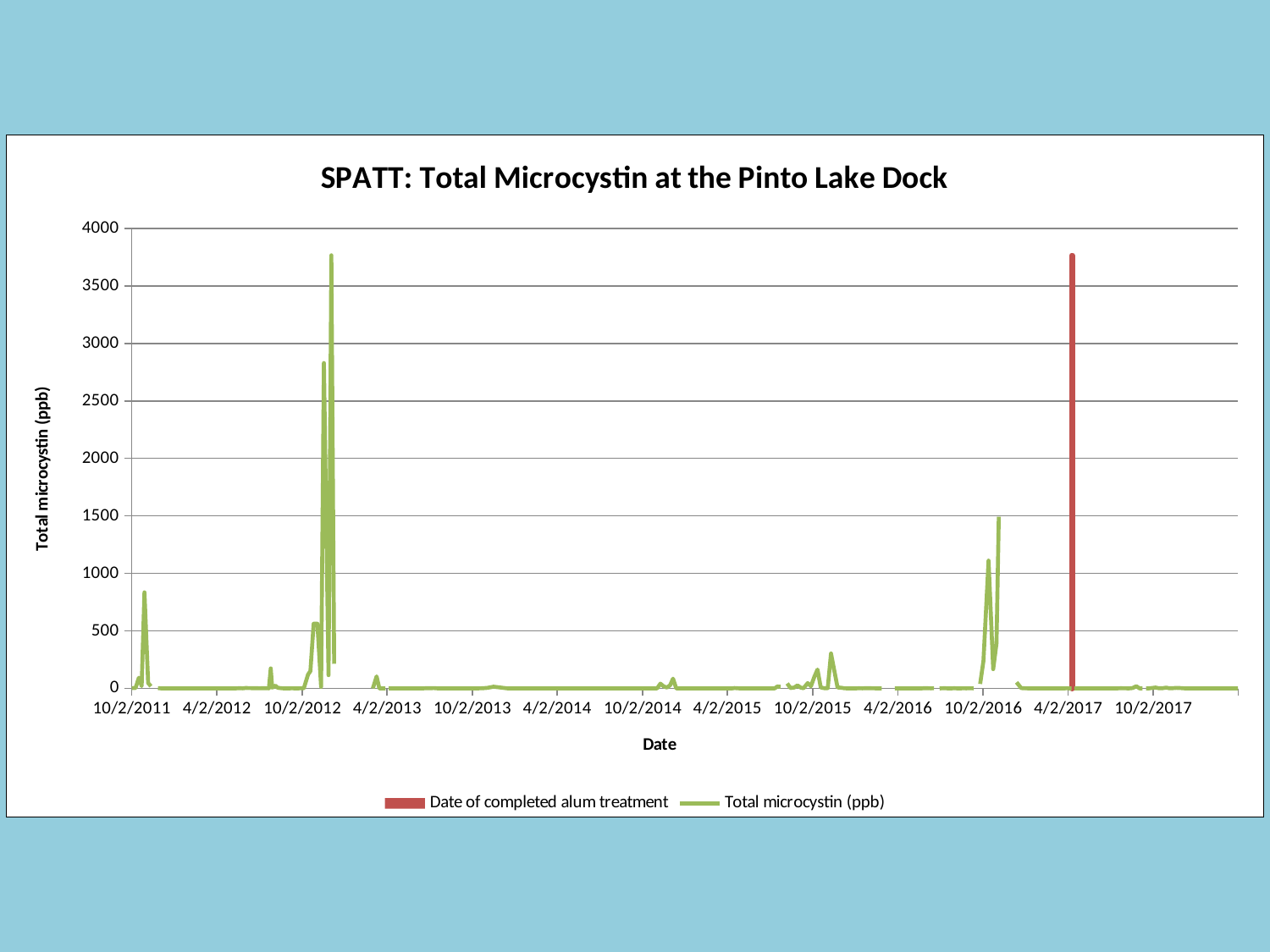
Is the total microcystin peak shortly after 10/2/2011 greater or less than 500? greater Is the highest total microcystin peak shortly after 10/2/2016 greater or less than 1000? greater What is the title of the chart? SPATT: Total Microcystin at the Pinto Lake Dock What kind of chart is shown on the slide? combination bar and line chart In which period does the highest total microcystin value on the chart occur? late 2012 Are the total microcystin values after the alum treatment date (4/2/2017 onward) greater or less than 500? less How many series does the legend list? 2 What are the two entries in the chart legend? Date of completed alum treatment; Total microcystin (ppb) Which is higher: the total microcystin peak in late 2012 or the peak in late 2016? late 2012 Which is higher: the total microcystin peak in late 2011 or the peak in late 2015? late 2011